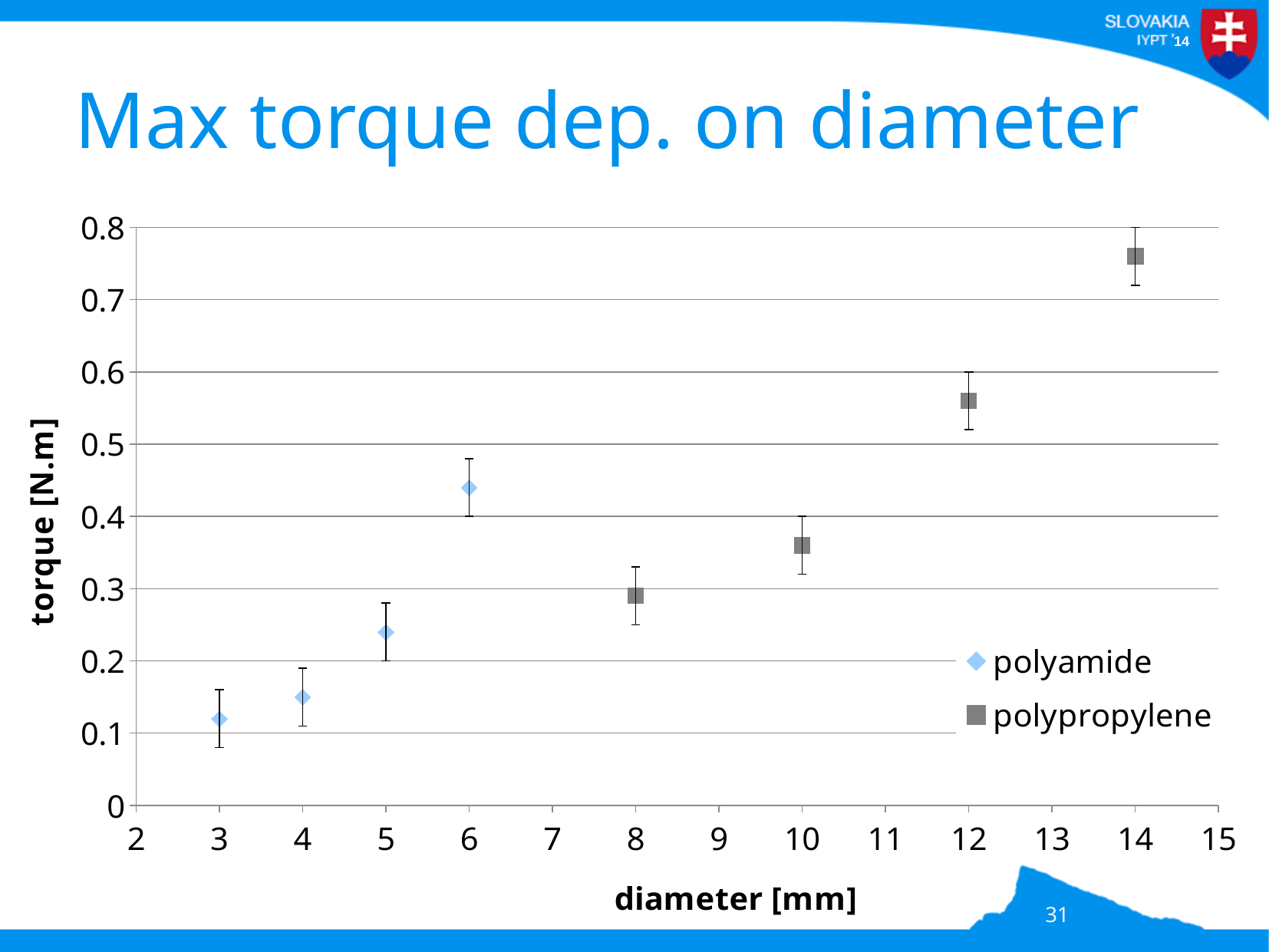
At which diameter is the highest torque value plotted? 14 mm Which is larger: the polyamide torque at 6 mm or the polypropylene torque at 8 mm? polyamide at 6 mm Is the polypropylene torque at 10 mm greater or less than 0.4 N.m? less What kind of chart is shown on the slide? scatter plot Is the polypropylene torque at 14 mm greater or less than 0.7 N.m? greater How many polypropylene data points are plotted? 4 What are the two series named in the legend? polyamide and polypropylene How many series does the legend list? 2 Does the maximum torque rise or fall as the diameter increases? rises At which diameter is the lowest torque value plotted? 3 mm Is the polyamide torque at 6 mm greater or less than 0.4 N.m? greater How many data points are plotted in total across both series? 8